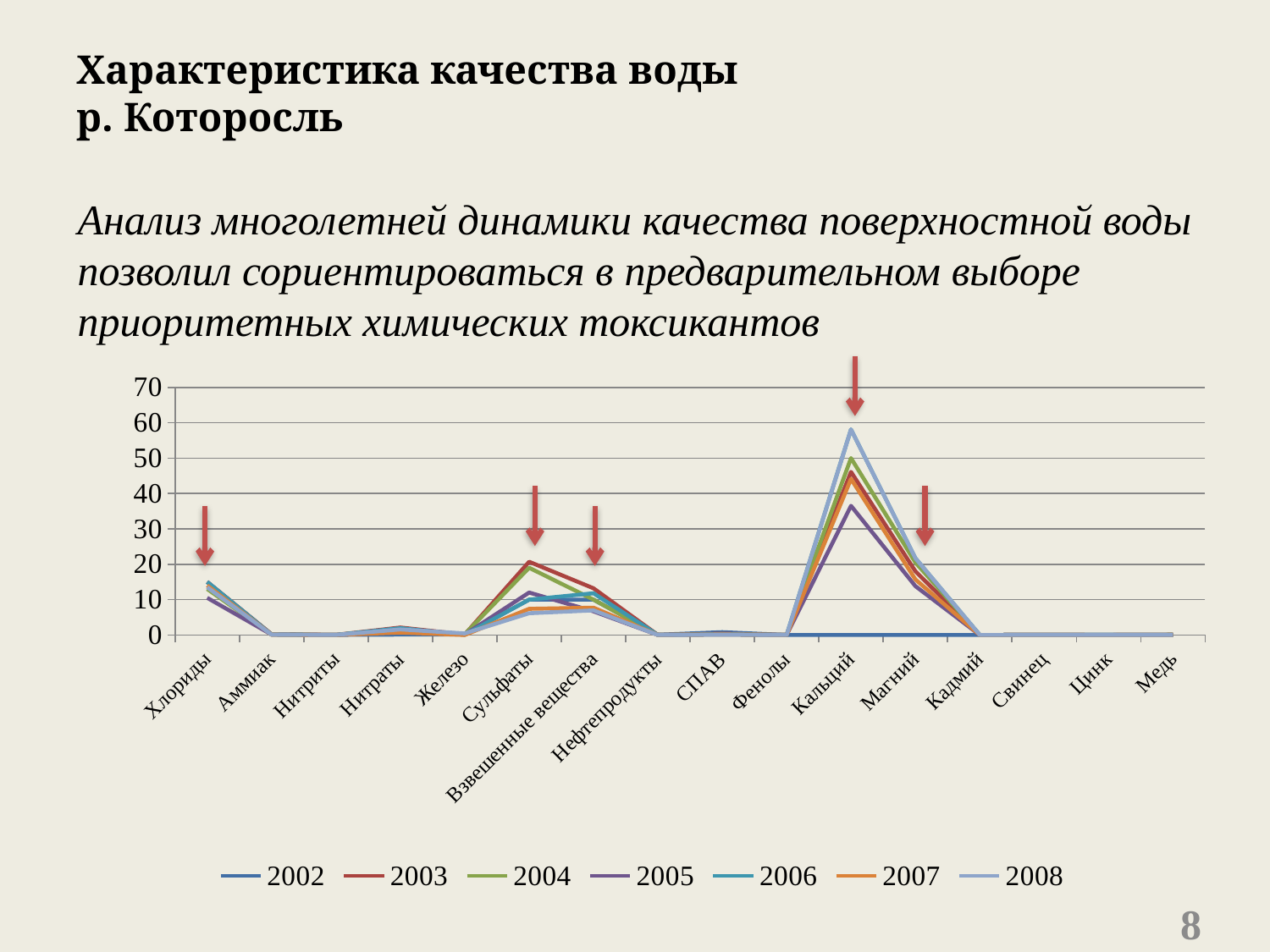
Is the value for Кальций in 2008 greater or less than 50? greater Is the value for Аммиак in 2008 greater or less than 10? less Which series has the higher value for Кальций, 2008 or 2005? 2008 What is the highest value shown on the y axis? 70 Is the value for Кальций in 2003 greater or less than 40? greater How many series does the legend list? 7 Which category has the highest values across the series? Кальций What kind of chart is shown on the slide? line chart How many categories are shown along the x axis? 16